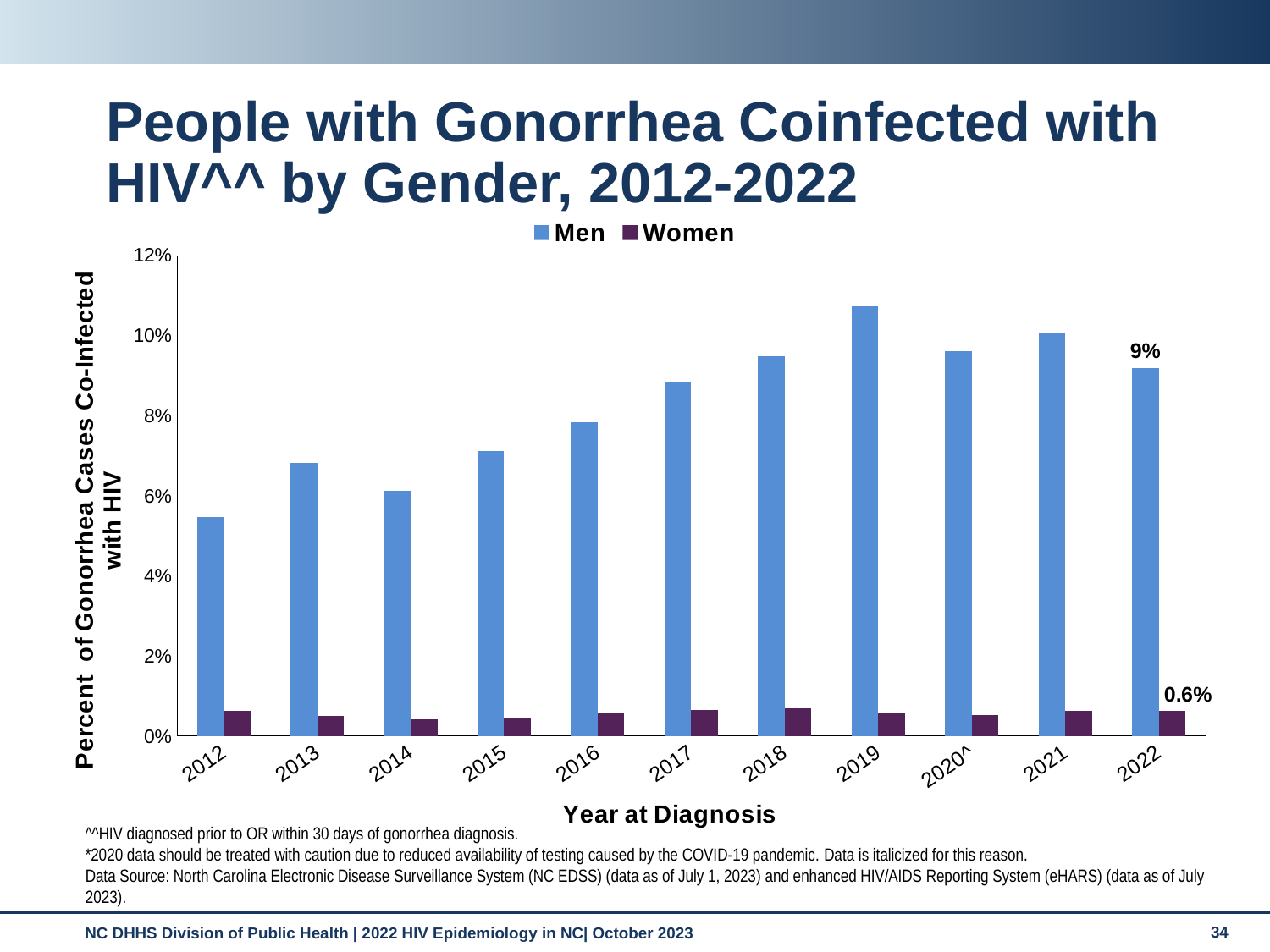
Which is larger in 2022, the value for Men or the value for Women? Men In which year is the Men series lowest? 2012 Does the Men series generally rise or fall from 2012 to 2019? rise How many years are shown on the x axis? 11 What is the value for Women in 2022? 0.6% What is the value for Men in 2022? 9% What kind of chart is shown on the slide? bar chart What is the difference between the Men and Women values in 2022? 8.4% In which year is the Men series highest? 2019 Is the value for Men in 2012 greater or less than 6%? less Is the value for Men in 2019 greater or less than 10%? greater How many series does the legend list? 2